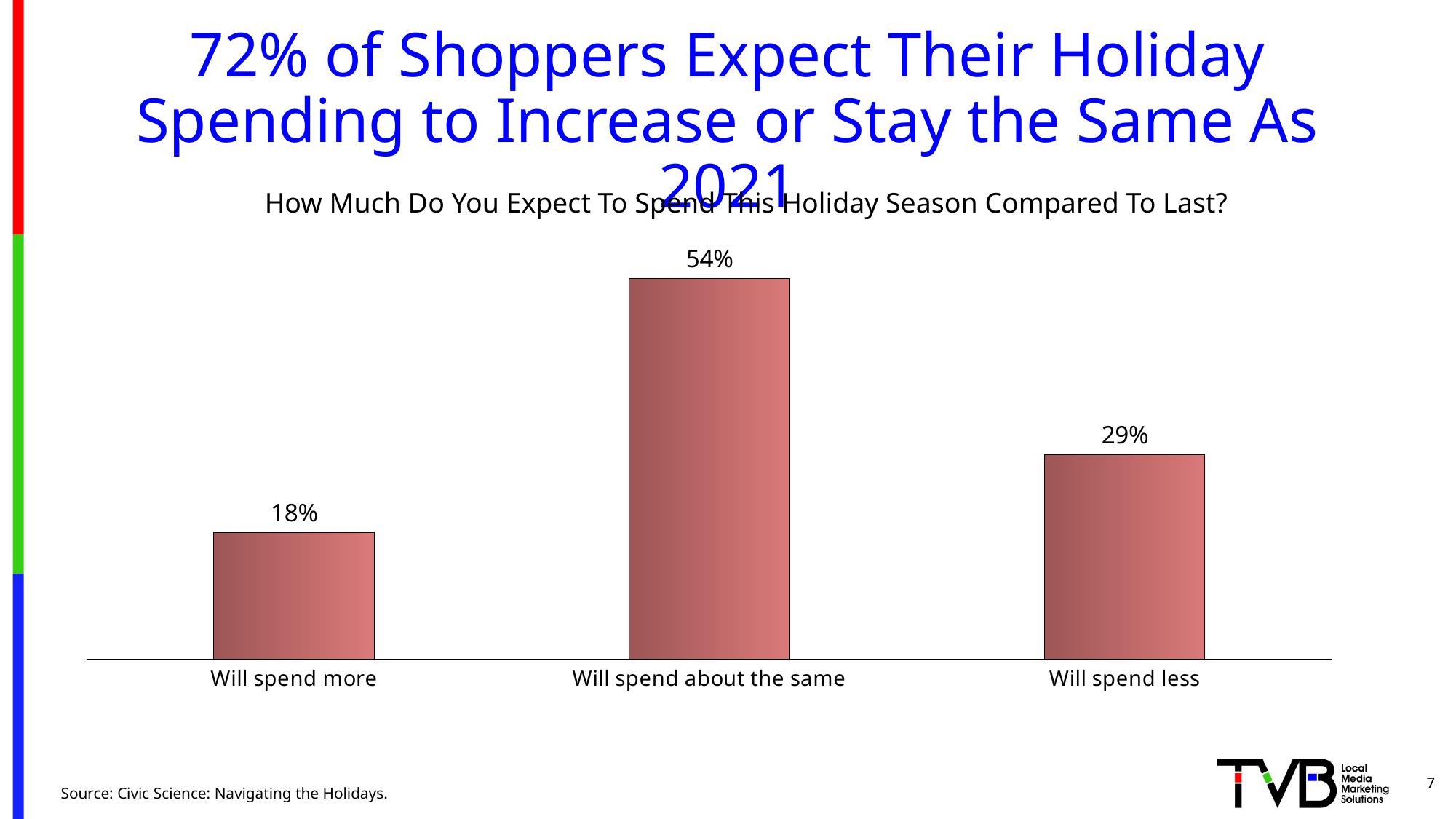
What is the source cited for the chart data? Civic Science: Navigating the Holidays. Which response category has the highest value? Will spend about the same What is the chart's title? How Much Do You Expect To Spend This Holiday Season Compared To Last? What percentage of shoppers say they will spend more this holiday season? 18% What is the difference between the share who will spend about the same and the share who will spend less? 25% What kind of chart is shown on the slide? Bar chart What percentage of shoppers say they will spend about the same this holiday season? 54% What percentage of shoppers say they will spend less this holiday season? 29% What is the difference between the share who will spend less and the share who will spend more? 11% Which is larger: the share who will spend less or the share who will spend more? Will spend less Which response category has the lowest value? Will spend more How many response categories are shown in the chart? 3